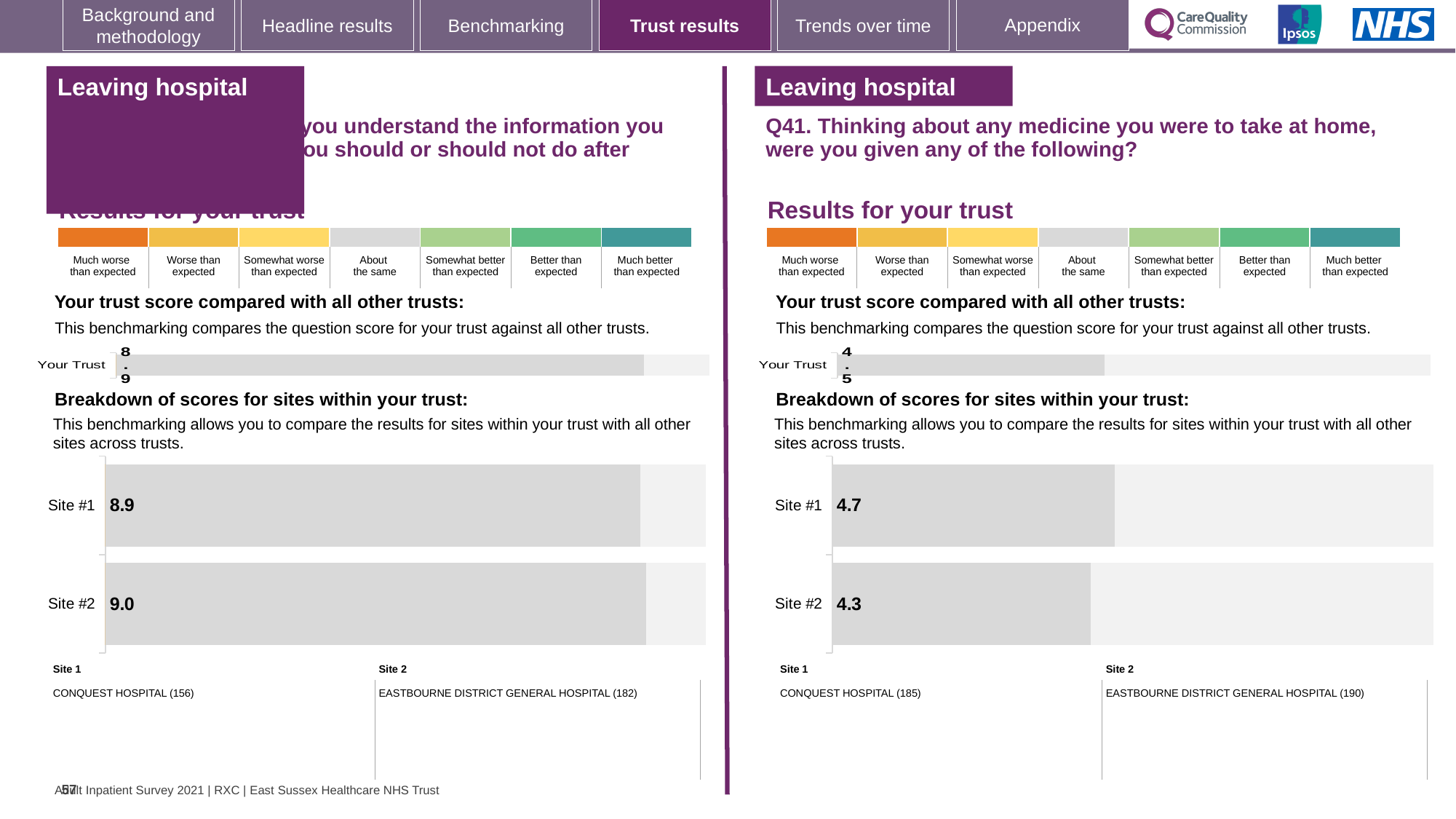
On the left-hand side of the slide, what is the 'Your Trust' score shown in the trust benchmarking bar? 8.9 On the right-hand side of the slide for Q41, what is the 'Your Trust' score shown in the trust benchmarking bar? 4.5 On the right-hand chart for Q41 (breakdown of scores for sites), what is the score for Site #2? 4.3 On the right-hand chart for Q41, what is the difference between the Site #1 and Site #2 scores? 0.4 On the left-hand chart (breakdown of scores for sites), which site has the lower score? Site #1 On the left-hand chart (breakdown of scores for sites), what is the difference between the Site #2 and Site #1 scores? 0.1 On the right-hand chart for Q41, which site has the higher score? Site #1 How many sites are shown in the right-hand breakdown chart for Q41? 2 On the right-hand chart for Q41 (breakdown of scores for sites), what is the score for Site #1? 4.7 What type of chart is used for the breakdown of scores for sites on the right-hand side of the slide? Bar chart On the left-hand chart (breakdown of scores for sites), what is the score for Site #2? 9.0 On the left-hand chart (breakdown of scores for sites), what is the score for Site #1? 8.9